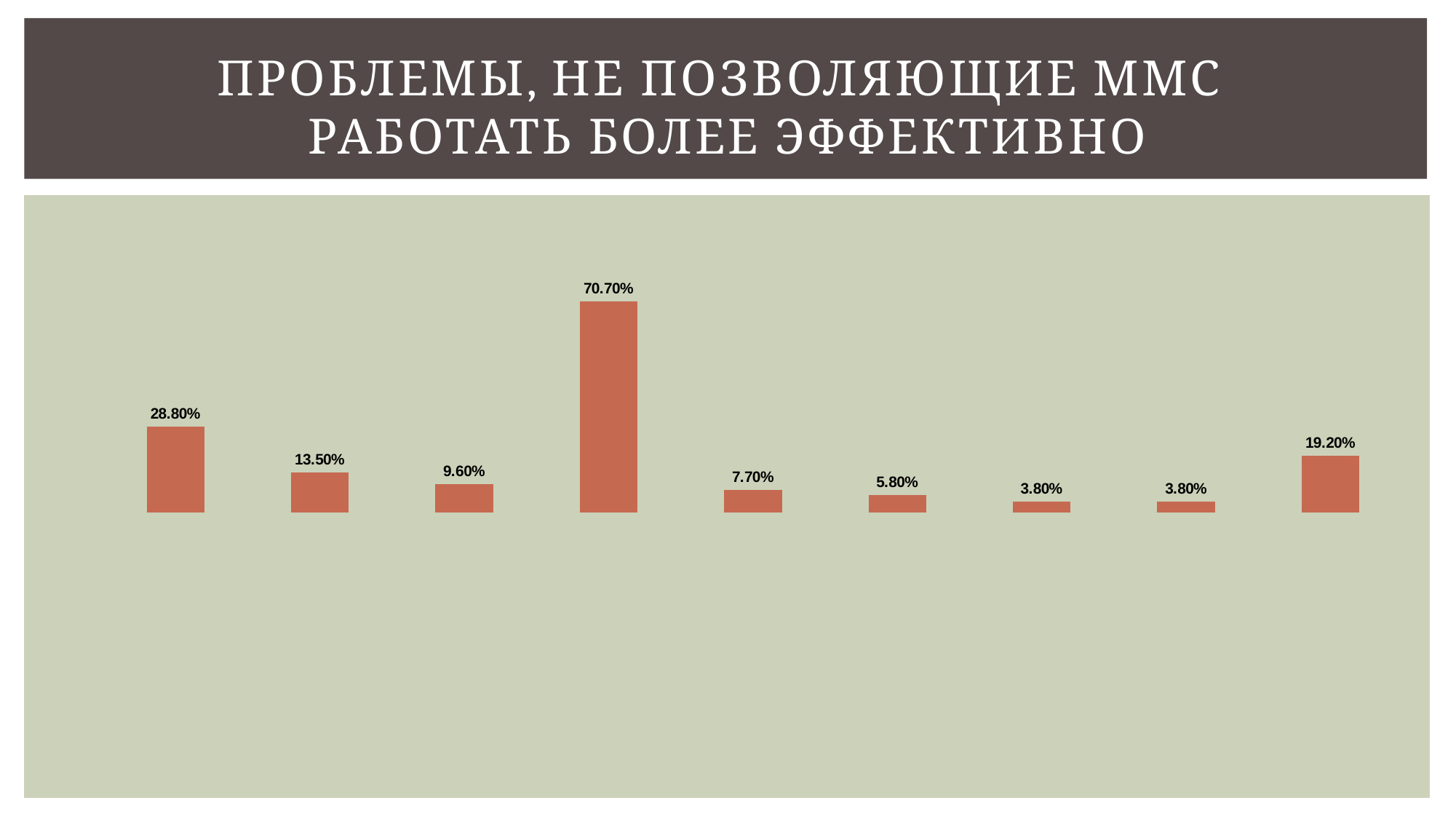
How many bars are plotted in the chart? 9 What is the difference between the tallest bar (70.70%) and the leftmost bar (28.80%)? 41.90% What is the difference between the third bar (9.60%) and the fifth bar (7.70%)? 1.90% What is the value shown on the tallest bar? 70.70% What is the value of the second bar from the left? 13.50% What is the title of the slide containing the chart? ПРОБЛЕМЫ, НЕ ПОЗВОЛЯЮЩИЕ ММС РАБОТАТЬ БОЛЕЕ ЭФФЕКТИВНО What type of chart is shown on the slide? bar chart What is the lowest value labelled on any bar? 3.80% How many bars have a value of 3.80%? 2 Which is larger: the leftmost bar or the rightmost bar? the leftmost bar (28.80%) What is the value of the first (leftmost) bar? 28.80% What is the value of the last (rightmost) bar? 19.20%